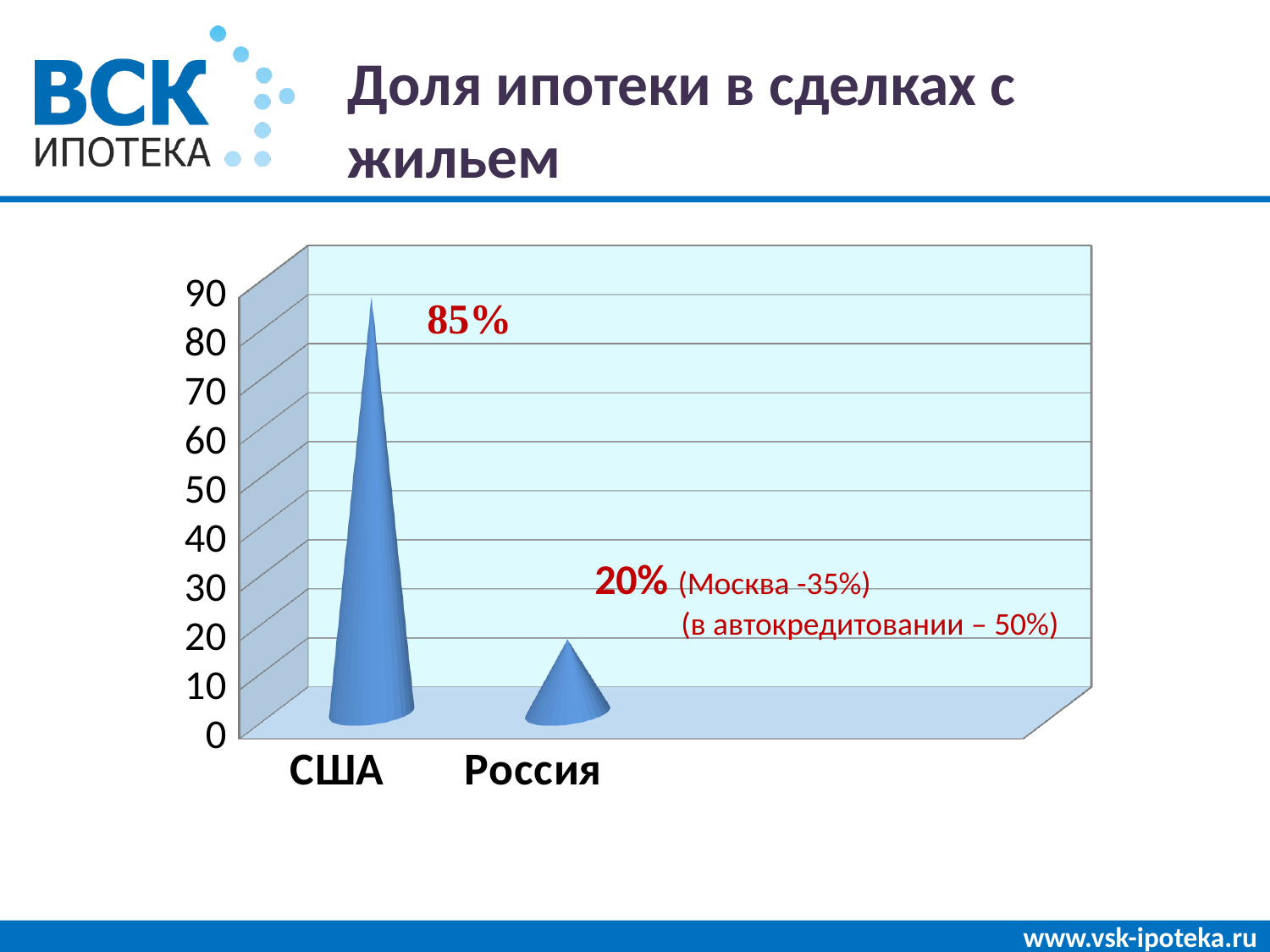
Which is larger, the value for США or the value for Россия? США What is the value shown for Россия? 20% Which category has the highest value? США How many categories are shown on the chart? 2 What is the highest value shown on the vertical axis? 90 What is the value shown for США? 85% What is the difference between the values for США and Россия? 65% Which category has the lowest value? Россия Is the value for Россия greater or less than 30? less Is the value for США greater or less than 50? greater What kind of chart is shown on the slide? bar chart What is the title of the slide? Доля ипотеки в сделках с жильем